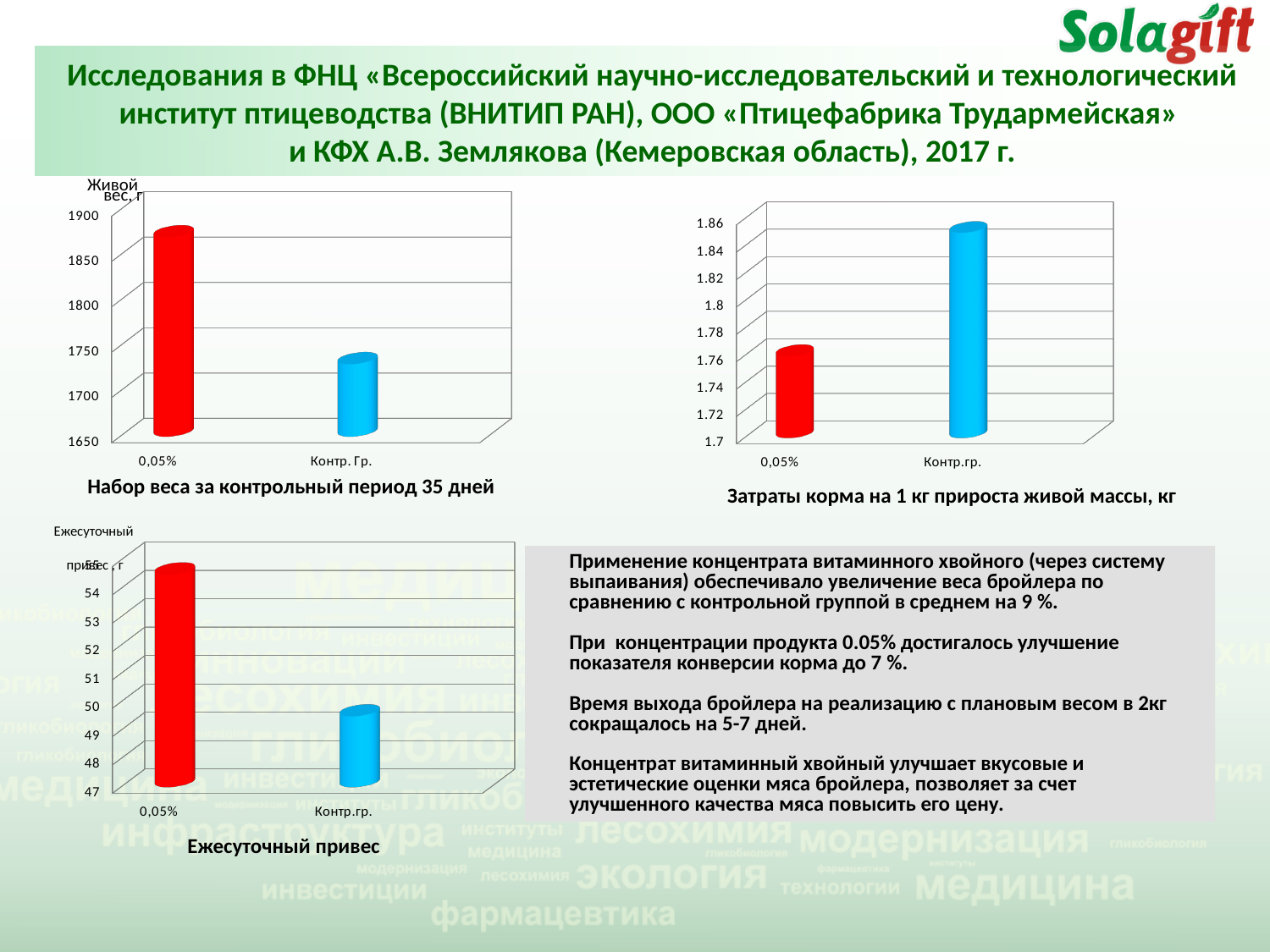
What kind of chart is the chart titled "Набор веса за контрольный период 35 дней"? bar chart In the chart titled "Затраты корма на 1 кг прироста живой массы, кг", is the value for 0,05% greater or less than 1.8? less In the chart titled "Ежесуточный привес", is the value for Контр.гр. greater or less than 51? less How many categories are shown in the chart titled "Набор веса за контрольный период 35 дней"? 2 In the chart titled "Ежесуточный привес", which is larger: the value for 0,05% or the value for Контр.гр.? 0,05% In the chart titled "Затраты корма на 1 кг прироста живой массы, кг", which category has the lower value? 0,05% In the chart titled "Набор веса за контрольный период 35 дней", which category has the higher value? 0,05% In the chart titled "Ежесуточный привес", is the value for 0,05% greater or less than 53? greater What is the title of the chart in the top right of the slide? Затраты корма на 1 кг прироста живой массы, кг